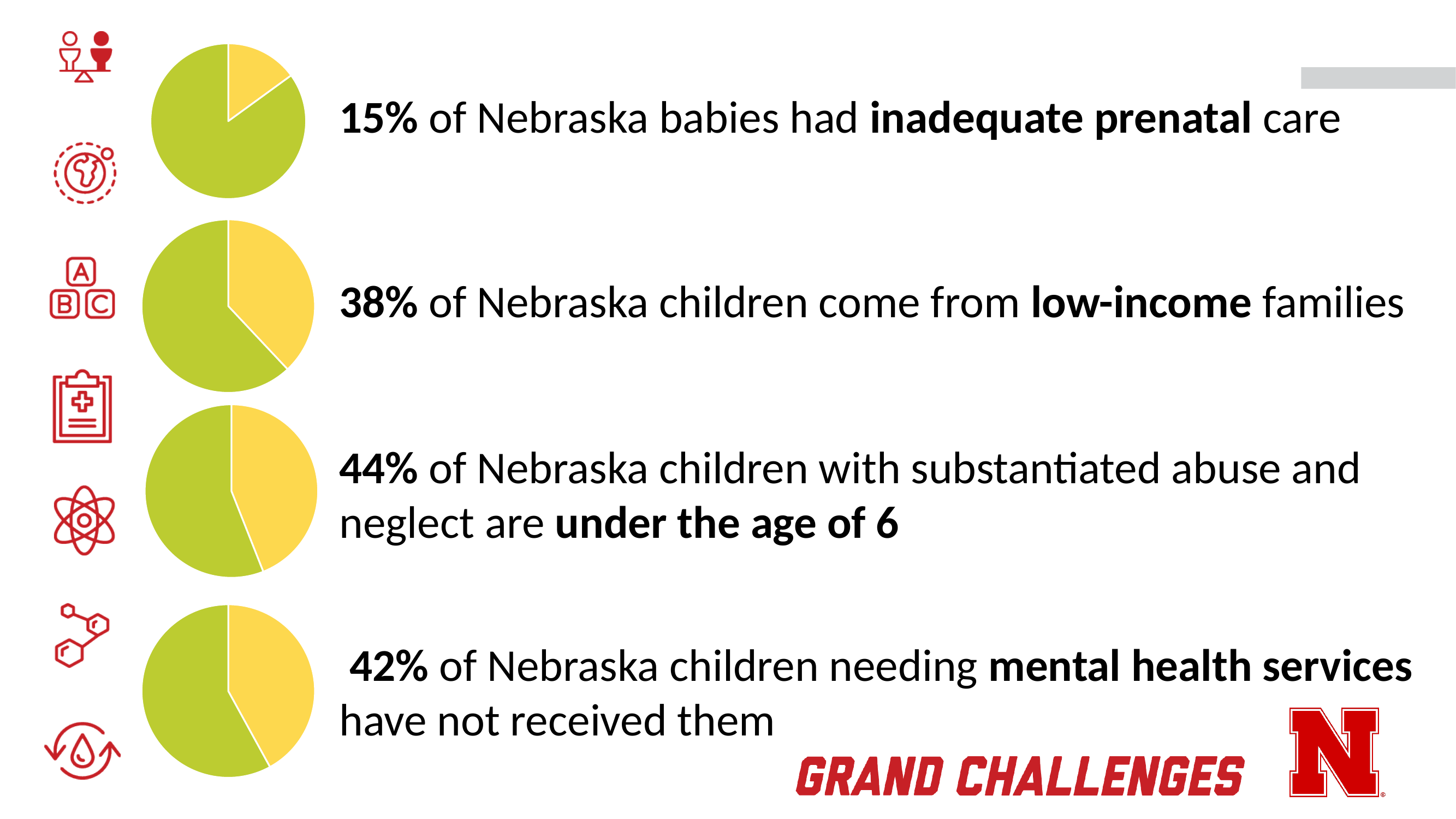
In the second pie chart from the top, what share of Nebraska children come from low-income families? 38% In the top pie chart, is the yellow slice for inadequate prenatal care greater or less than 25%? less In the third pie chart from the top, what share of Nebraska children with substantiated abuse and neglect are under the age of 6? 44% What colour is used for the highlighted slice in each pie chart? Yellow In the top pie chart, what share of Nebraska babies had inadequate prenatal care? 15% How many pie charts are on the slide? 4 What is the difference in percentage points between the share of children from low-income families and the share of babies with inadequate prenatal care? 23 percentage points Across the four pie charts, which statistic has the largest highlighted share? Children with substantiated abuse and neglect under the age of 6 (44%) Across the four pie charts, which statistic has the smallest highlighted share? Inadequate prenatal care (15%) Which pie chart has the largest yellow slice: the one for inadequate prenatal care or the one for low-income families? Low-income families What kind of charts are shown on the slide? Pie charts